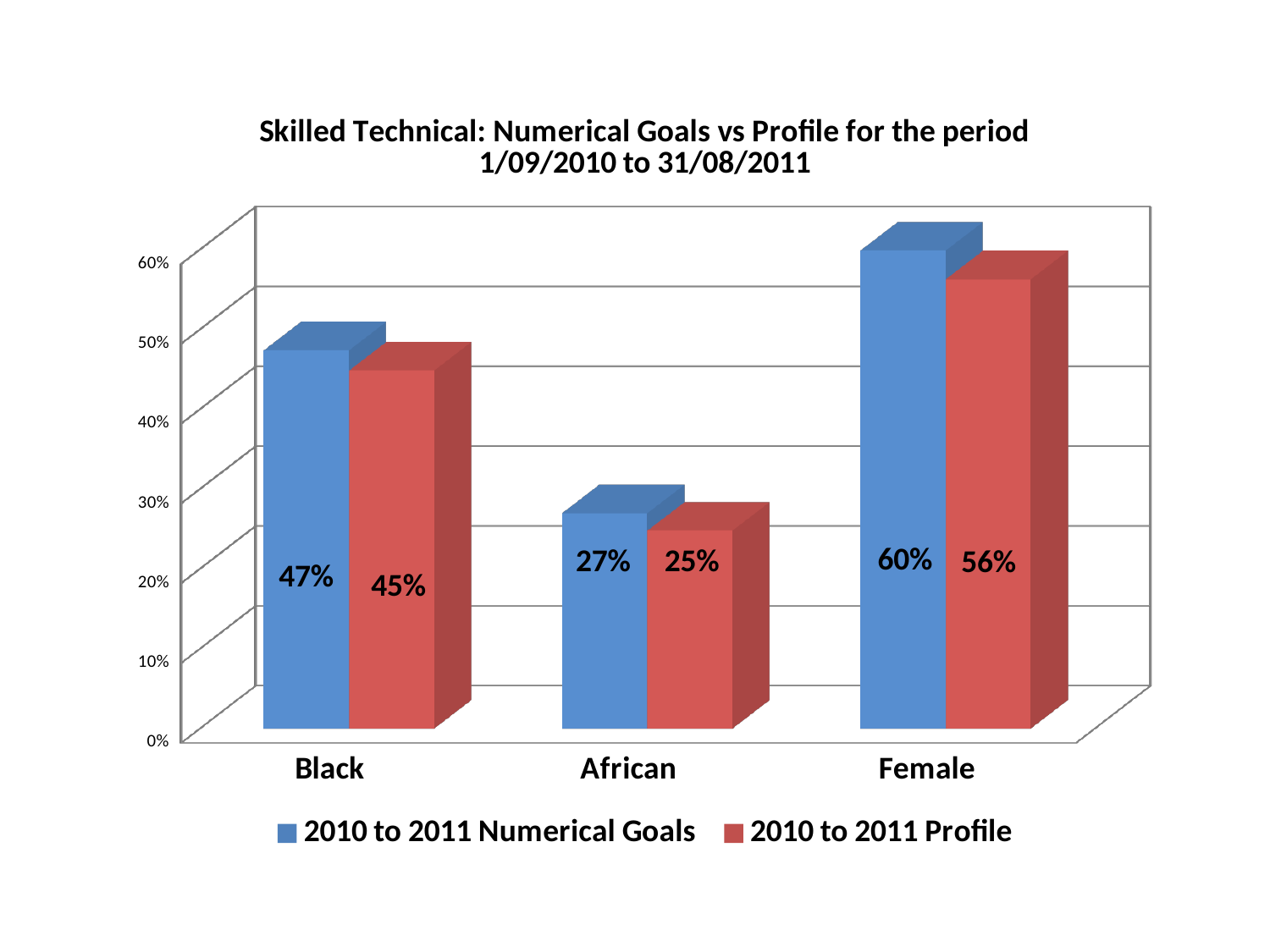
What is the 2010 to 2011 Numerical Goals value for Black? 47% Which category has the lowest 2010 to 2011 Profile value? African How many series does the legend list? 2 Which is larger for Black: the 2010 to 2011 Numerical Goals value or the 2010 to 2011 Profile value? 2010 to 2011 Numerical Goals Which colour represents the 2010 to 2011 Profile series? Red What is the difference between the Numerical Goals and Profile values for Female? 4% What kind of chart is shown on the slide? Bar chart What is the difference between the Numerical Goals values for Black and African? 20% Which category has the highest 2010 to 2011 Numerical Goals value? Female What is the 2010 to 2011 Profile value for Female? 56% What is the 2010 to 2011 Profile value for African? 25% How many categories are shown on the x axis? 3